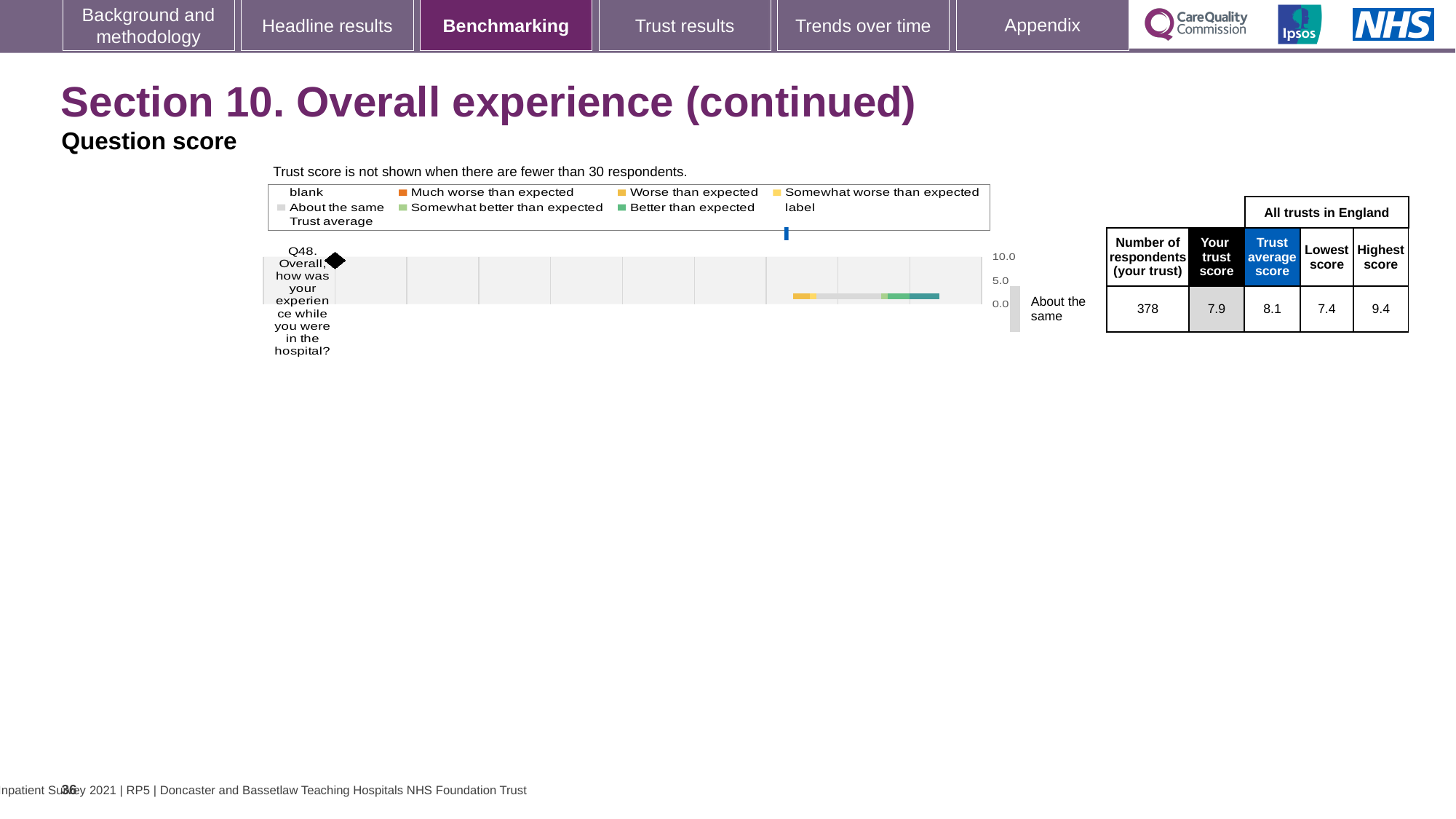
According to the table on the slide, what is the trust average score for Q48 across all trusts in England? 8.1 For Q48, which is larger: the trust's own score or the trust average score for all trusts in England? Trust average score What kind of chart is shown for Q48 on this slide? bar chart According to the table on the slide, how many respondents from the trust answered Q48? 378 For Q48, what is the difference between the highest score and the lowest score among all trusts in England? 2.0 How many survey questions are plotted in the chart on this slide? 1 According to the table on the slide, what is the highest score for Q48 among all trusts in England? 9.4 Which question number is plotted in the chart on this slide? Q48 What benchmark category label is shown to the right of the Q48 chart? About the same According to the table on the slide, what is the trust's score for Q48? 7.9 For Q48, what is the difference between the trust average score and the trust's own score? 0.2 According to the table on the slide, what is the lowest score for Q48 among all trusts in England? 7.4